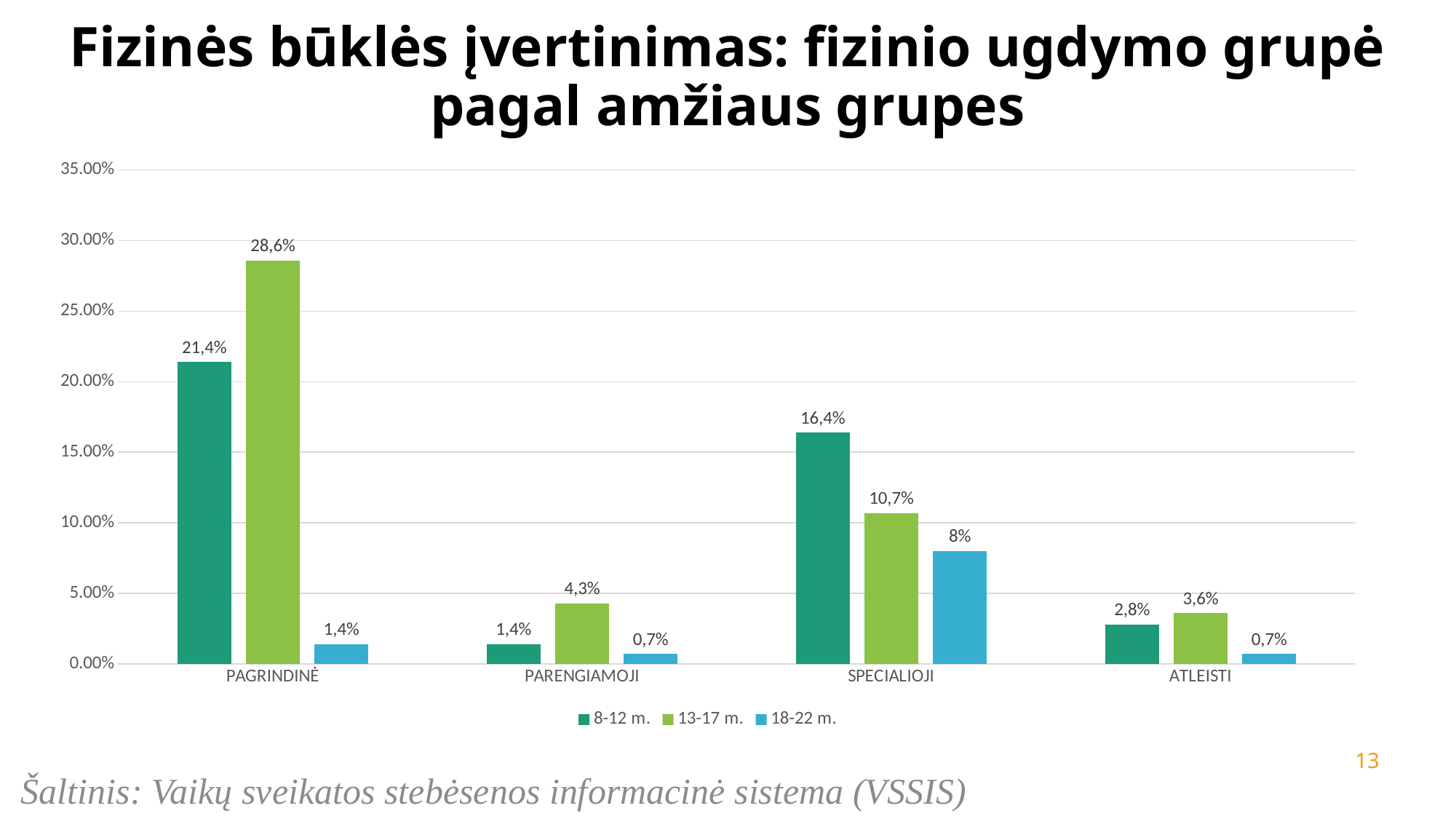
What is the value for the 18-22 m. series in the ATLEISTI category? 0,7% What kind of chart is shown on the slide? bar chart How many series does the legend list? 3 What is the value for the 18-22 m. series in the SPECIALIOJI category? 8% What is the value for the 8-12 m. series in the SPECIALIOJI category? 16,4% Which category has the highest value for the 8-12 m. series? PAGRINDINĖ Which is larger in the SPECIALIOJI category: the 8-12 m. value or the 13-17 m. value? 8-12 m. What is the value for the 13-17 m. series in the PAGRINDINĖ category? 28,6% How many categories are shown on the x axis? 4 Is the value for the 13-17 m. series in the PAGRINDINĖ category greater or less than 25.00%? greater What is the difference between the 13-17 m. and 8-12 m. values in the PAGRINDINĖ category? 7,2%